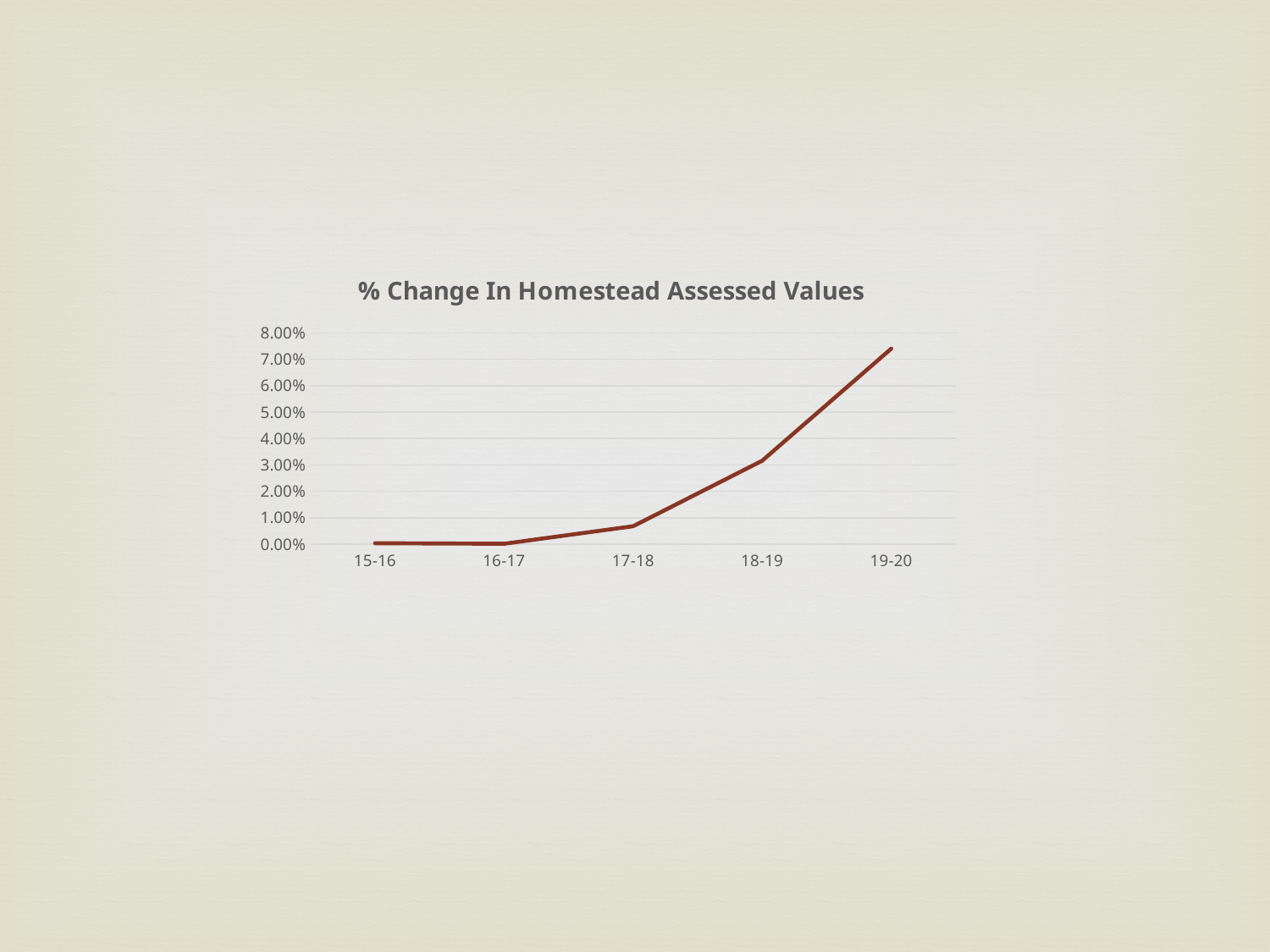
Is the value for 18-19 greater or less than 2.00%? greater Which year has the highest % change in homestead assessed values? 19-20 Which is larger, the value for 19-20 or the value for 18-19? 19-20 Is the value for 18-19 greater or less than 4.00%? less Is the value for 16-17 greater or less than 1.00%? less Do the values generally rise or fall from 15-16 to 19-20? rise What kind of chart is shown on the slide? line chart How many data points are plotted on the line? 5 Which is larger, the value for 18-19 or the value for 17-18? 18-19 What is the title of the chart? % Change In Homestead Assessed Values